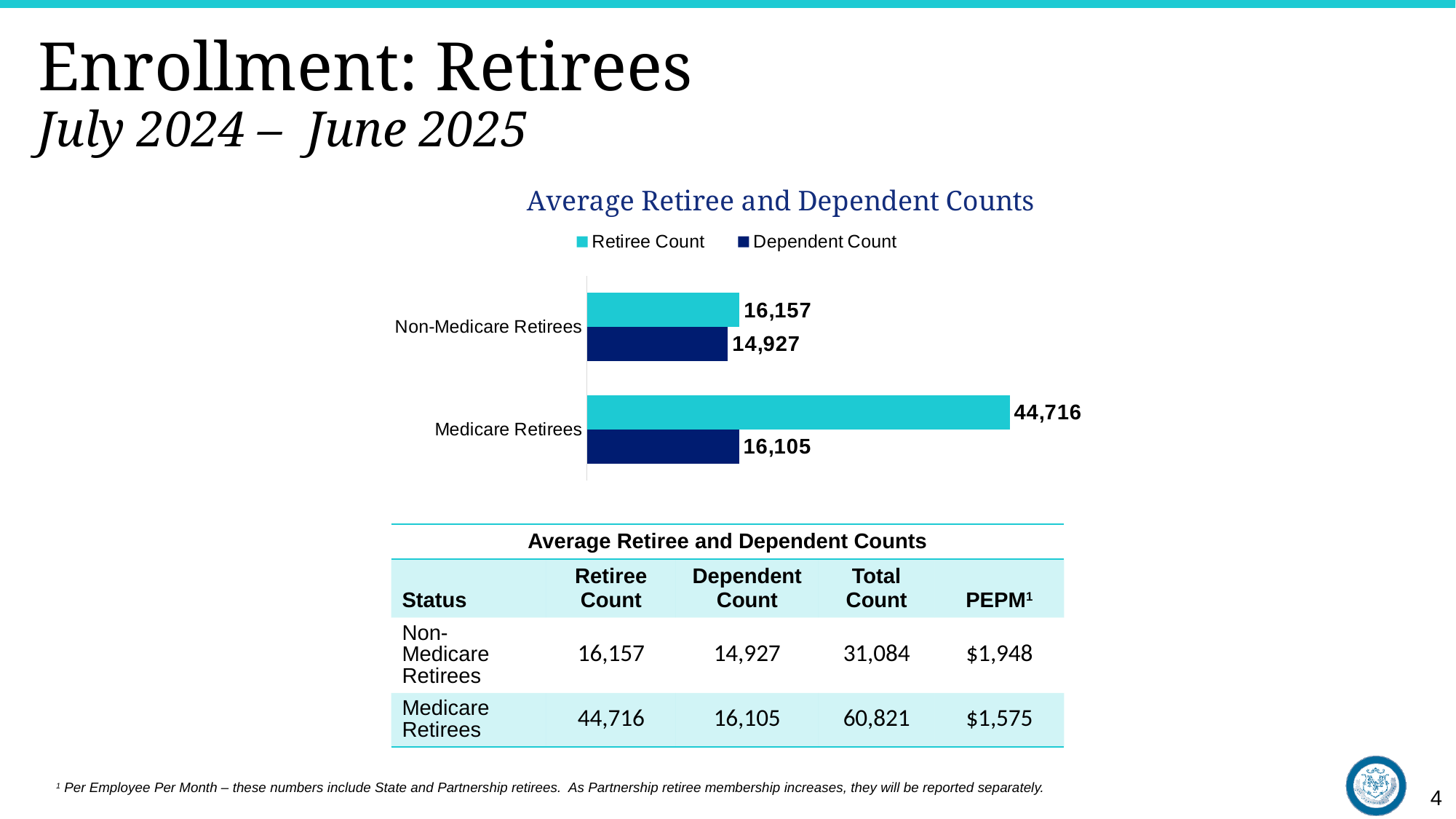
What kind of chart is shown on the slide? Bar chart Which category has the highest Retiree Count in the chart? Medicare Retirees What is the title of the chart? Average Retiree and Dependent Counts What is the Retiree Count for Medicare Retirees in the chart? 44,716 What is the Dependent Count for Non-Medicare Retirees in the chart? 14,927 Which is larger: the Retiree Count or the Dependent Count for Medicare Retirees? Retiree Count Which category has the lowest Dependent Count in the chart? Non-Medicare Retirees What is the Dependent Count for Medicare Retirees in the chart? 16,105 How many categories are shown on the chart? 2 What is the difference between the Retiree Count for Medicare Retirees and the Retiree Count for Non-Medicare Retirees? 28,559 How many series does the chart legend list? 2 What is the Retiree Count for Non-Medicare Retirees in the chart? 16,157